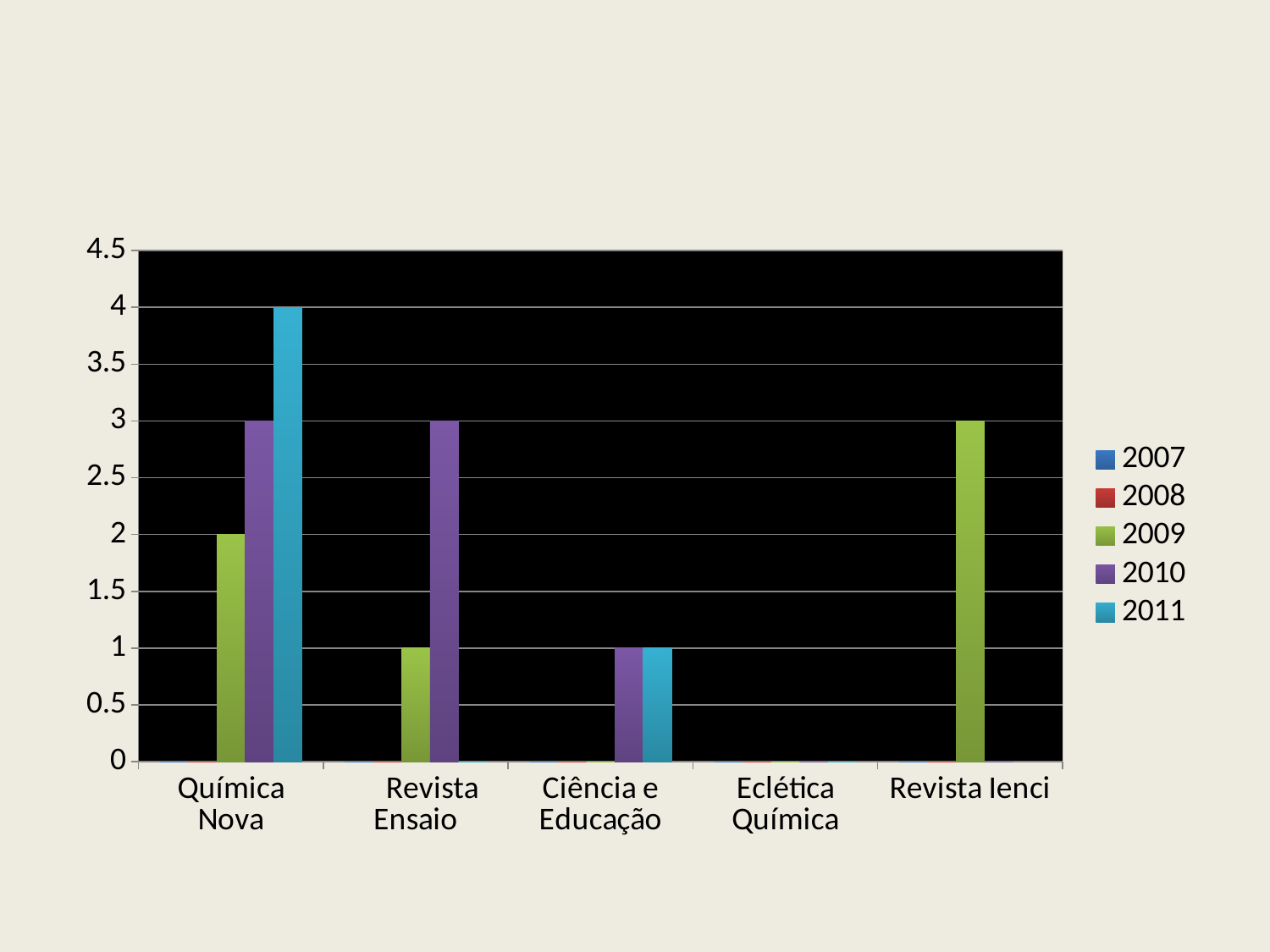
Which category has the highest bar in the chart? Química Nova What is the value for Química Nova in 2010? 3 What kind of chart is shown on the slide? bar chart Which is larger for Revista Ensaio: the 2009 value or the 2010 value? 2010 How many series does the legend list? 5 Which legend entry is shown in purple? 2010 What is the value for Revista Ensaio in 2010? 3 What is the value for Revista Ienci in 2009? 3 What is the value for Química Nova in 2011? 4 Is the value for Química Nova in 2011 greater or less than 3? greater How many categories are shown on the x axis? 5 What is the difference between the 2011 and 2009 values for Química Nova? 2